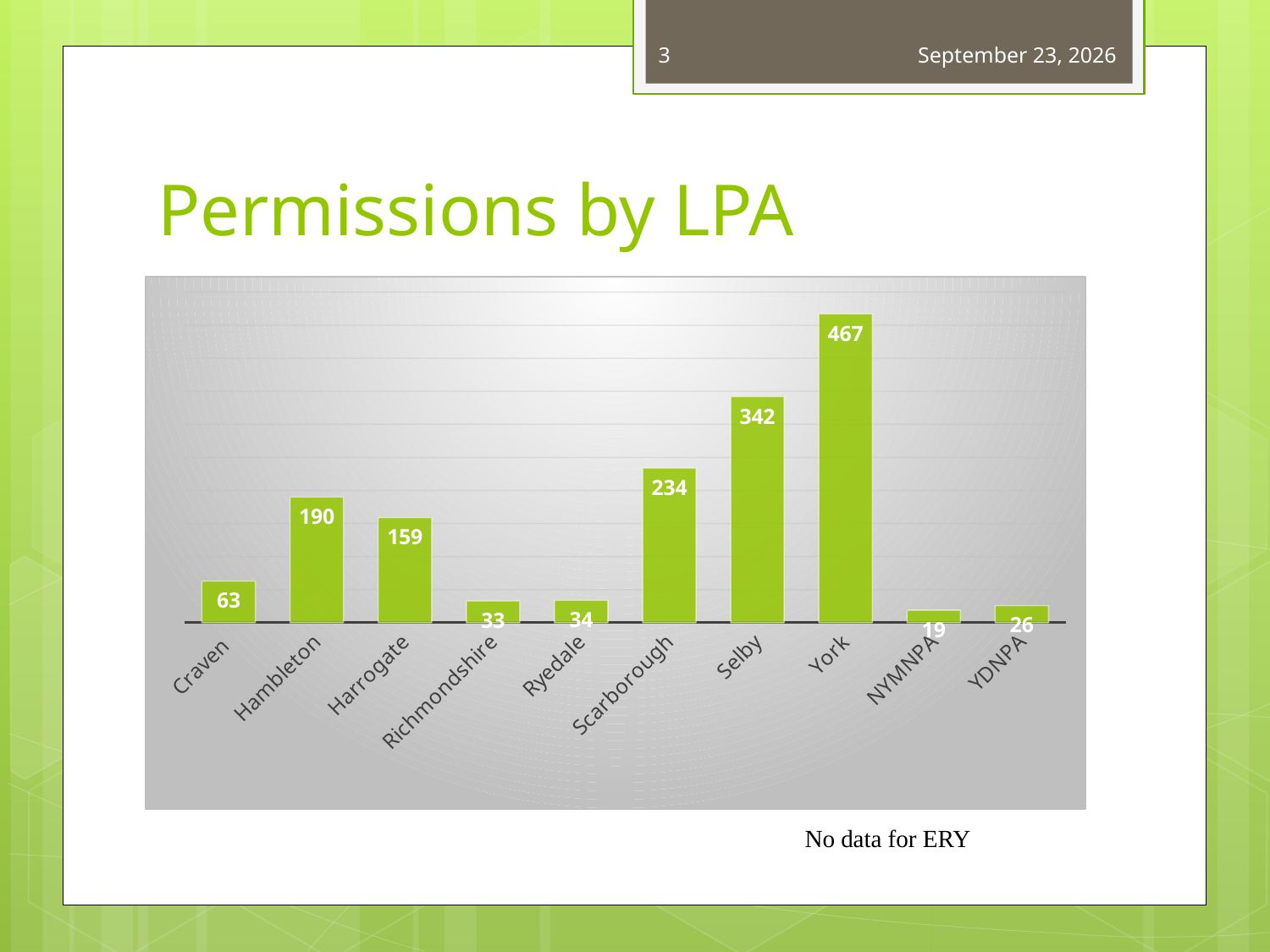
What is the value for York? 467 What is the difference between the values for York and Selby? 125 What is the value for Scarborough? 234 How many LPAs are shown on the chart? 10 Which LPA has the lowest value? NYMNPA Which is larger, the value for Craven or the value for YDNPA? Craven What is the value for NYMNPA? 19 What is the value for Hambleton? 190 What is the title of the slide containing the chart? Permissions by LPA Which LPA has the highest value? York What kind of chart is shown on the slide? Bar chart What is the difference between the values for Hambleton and Harrogate? 31